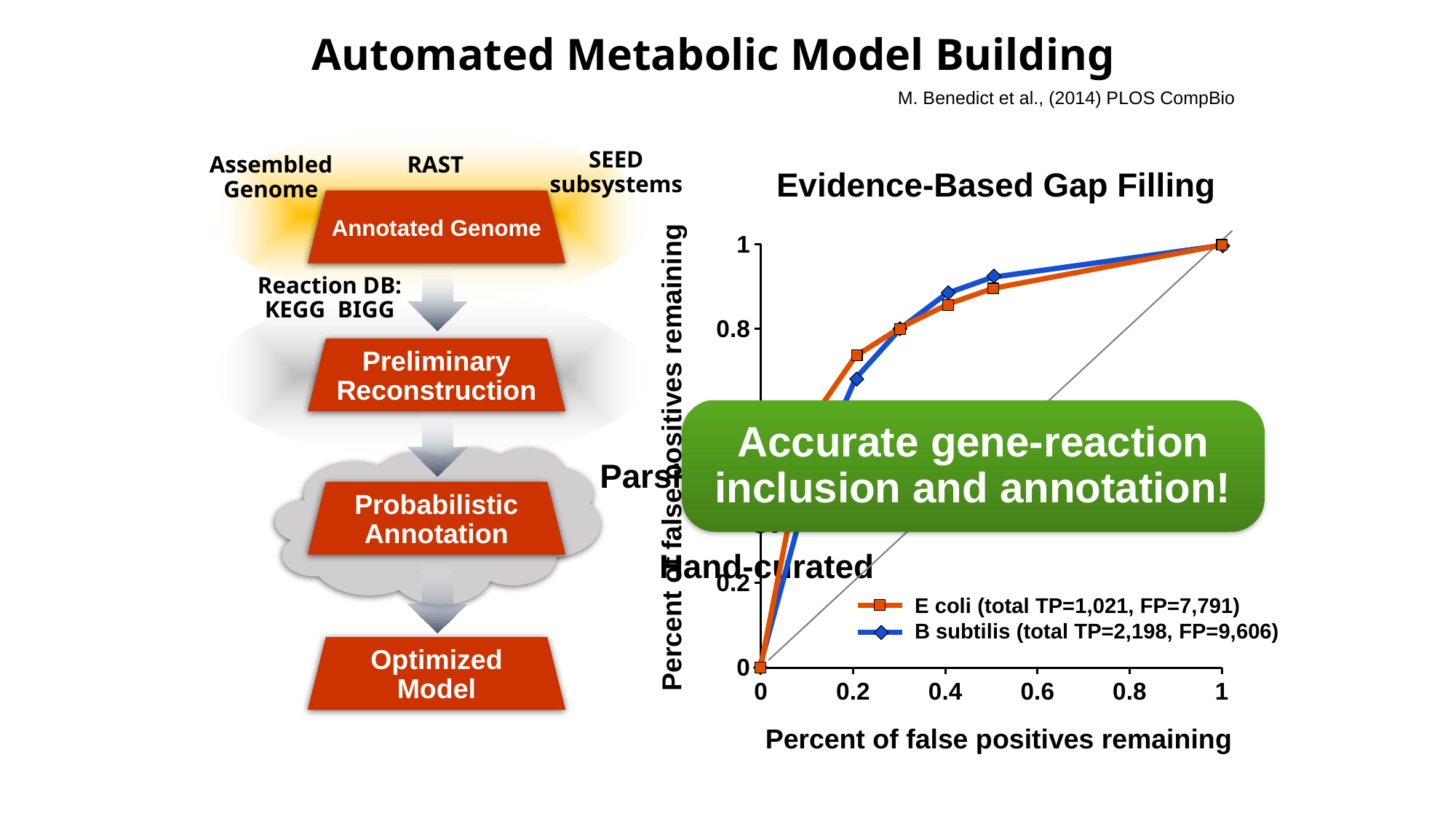
In the "Evidence-Based Gap Filling" chart, is the B subtilis value at x = 0.5 greater or less than 0.8? greater In the "Evidence-Based Gap Filling" chart, is the B subtilis value at x = 0.2 greater or less than 0.8? less In the "Evidence-Based Gap Filling" chart, what is the y value of the B subtilis series at x = 0? 0 In the "Evidence-Based Gap Filling" chart, what total TP does the legend give for E coli? 1,021 In the "Evidence-Based Gap Filling" chart, do the E coli values rise or fall as the x-axis value increases? rise What kind of chart is shown under the title "Evidence-Based Gap Filling"? line chart In the "Evidence-Based Gap Filling" chart, is the E coli value at x = 0.2 greater or less than 0.6? greater What is the x-axis label of the "Evidence-Based Gap Filling" chart? Percent of false positives remaining How many series does the legend of the "Evidence-Based Gap Filling" chart list? 2 In the "Evidence-Based Gap Filling" chart, at x = 0.2, which series has the higher value, E coli or B subtilis? E coli In the "Evidence-Based Gap Filling" chart, what is the y value of the E coli series at x = 1? 1